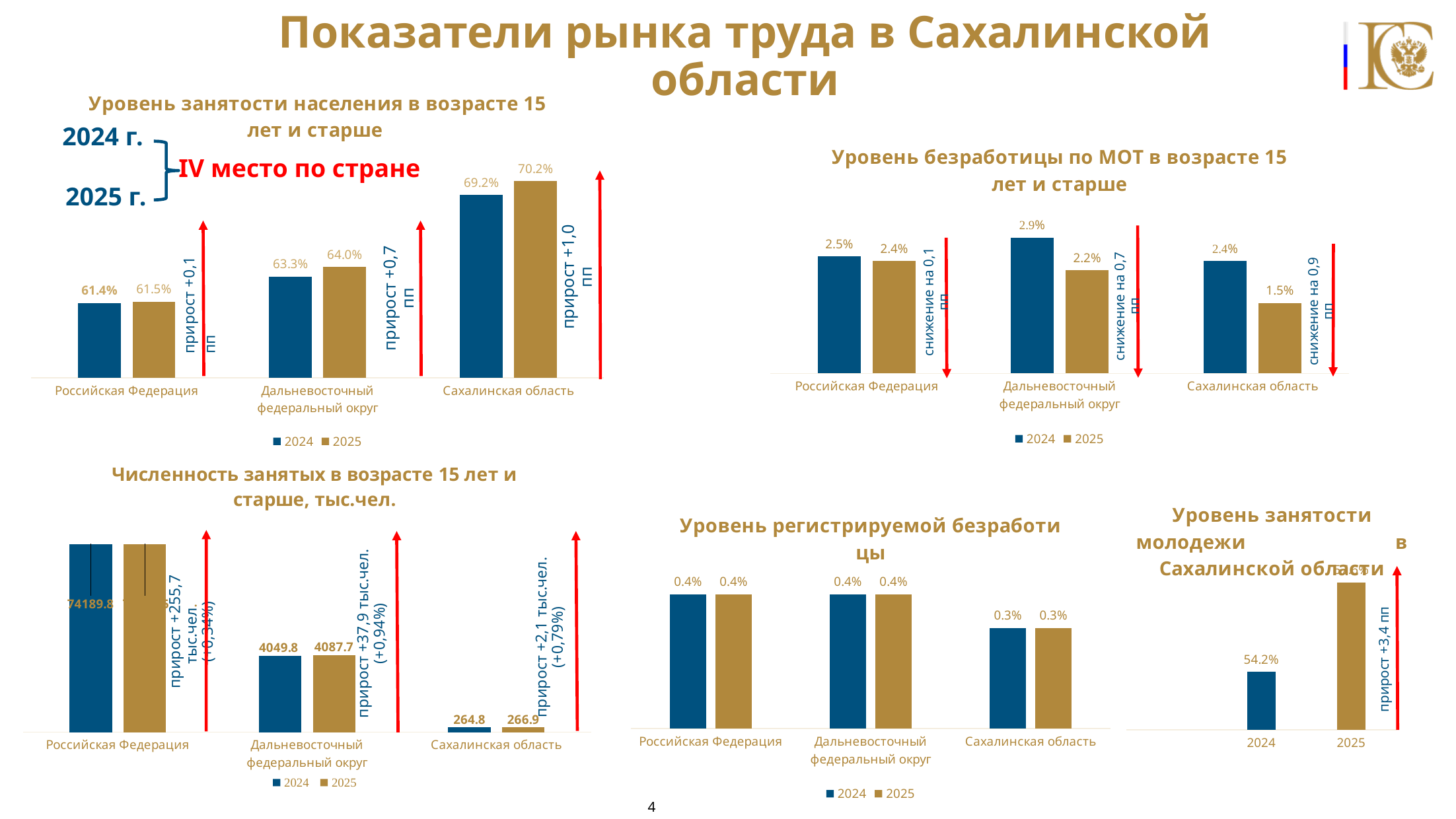
In the chart 'Уровень регистрируемой безработицы', what is the 2025 value for Сахалинская область? 0.3% In the chart 'Численность занятых в возрасте 15 лет и старше, тыс.чел.', what is the 2024 value for Сахалинская область? 264.8 In the chart 'Уровень занятости населения в возрасте 15 лет и старше', what is the 2025 value for Сахалинская область? 70.2% In the chart 'Уровень безработицы по МОТ в возрасте 15 лет и старше', which region has the highest 2024 value? Дальневосточный федеральный округ In the chart 'Численность занятых в возрасте 15 лет и старше, тыс.чел.', what is the 2025 value for Дальневосточный федеральный округ? 4087.7 In the chart 'Уровень занятости молодежи в Сахалинской области', what is the value for 2024? 54.2% In the chart 'Уровень занятости населения в возрасте 15 лет и старше', which region has the highest 2025 value? Сахалинская область In the chart 'Уровень безработицы по МОТ в возрасте 15 лет и старше', which region has the lowest 2025 value? Сахалинская область How many series does the legend of the chart 'Уровень регистрируемой безработицы' list? 2 In the chart 'Уровень безработицы по МОТ в возрасте 15 лет и старше', what is the 2025 value for Сахалинская область? 1.5% In the chart 'Уровень занятости населения в возрасте 15 лет и старше', what is the 2024 value for Российская Федерация? 61.4% In the chart 'Уровень занятости населения в возрасте 15 лет и старше', what is the difference between the 2025 and 2024 values for Дальневосточный федеральный округ? 0.7